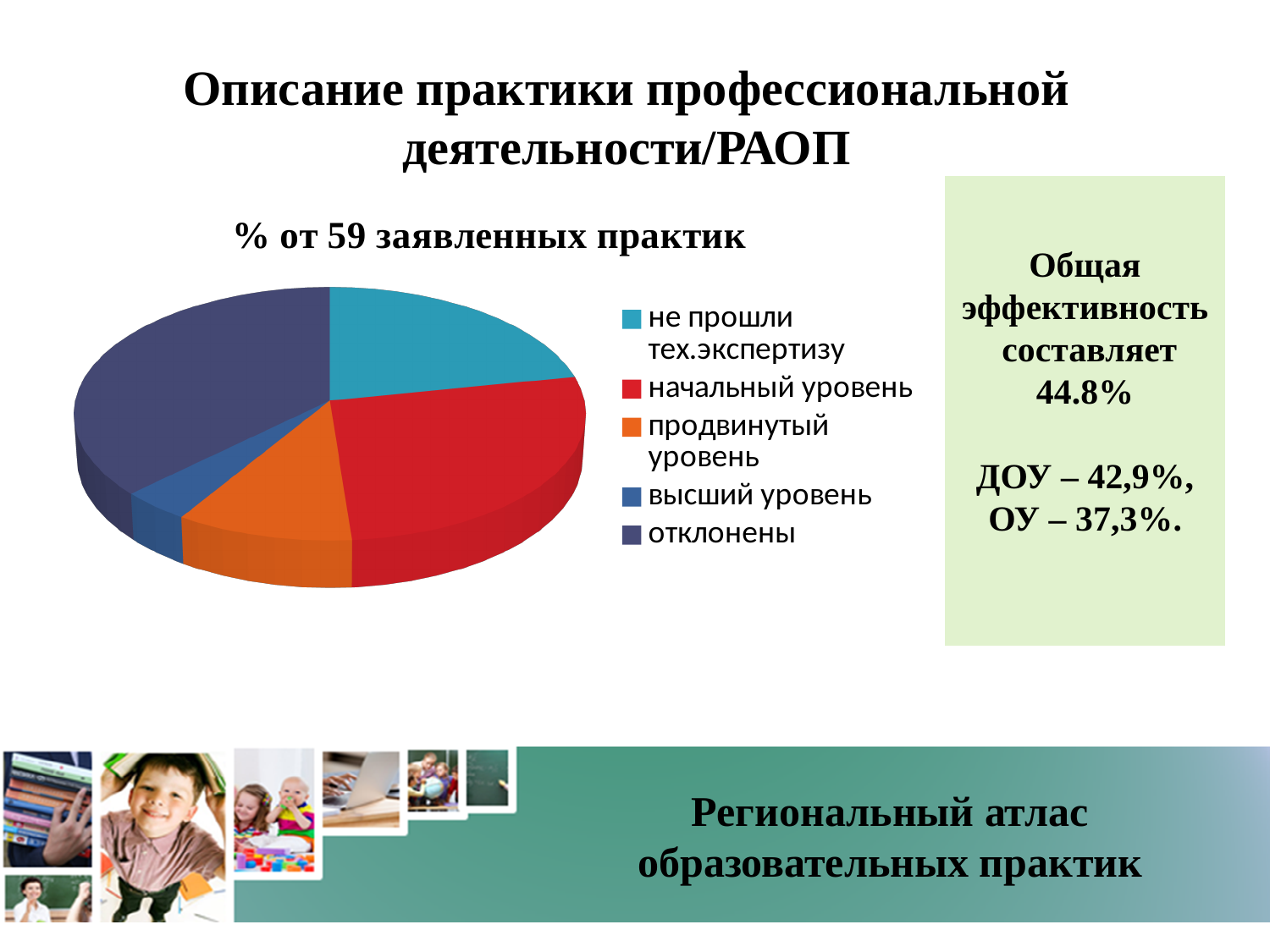
Which category has the smallest slice in the pie chart? высший уровень How many categories (slices) does the pie chart have? 5 Which slice is larger: не прошли тех.экспертизу or высший уровень? не прошли тех.экспертизу Which slice is larger: отклонены or продвинутый уровень? отклонены How many entries does the legend of the pie chart list? 5 Which slice is larger: начальный уровень or высший уровень? начальный уровень What kind of chart is shown on the slide? pie chart What is the title of the pie chart? % от 59 заявленных практик What colour is the slice for отклонены in the pie chart? dark blue/purple